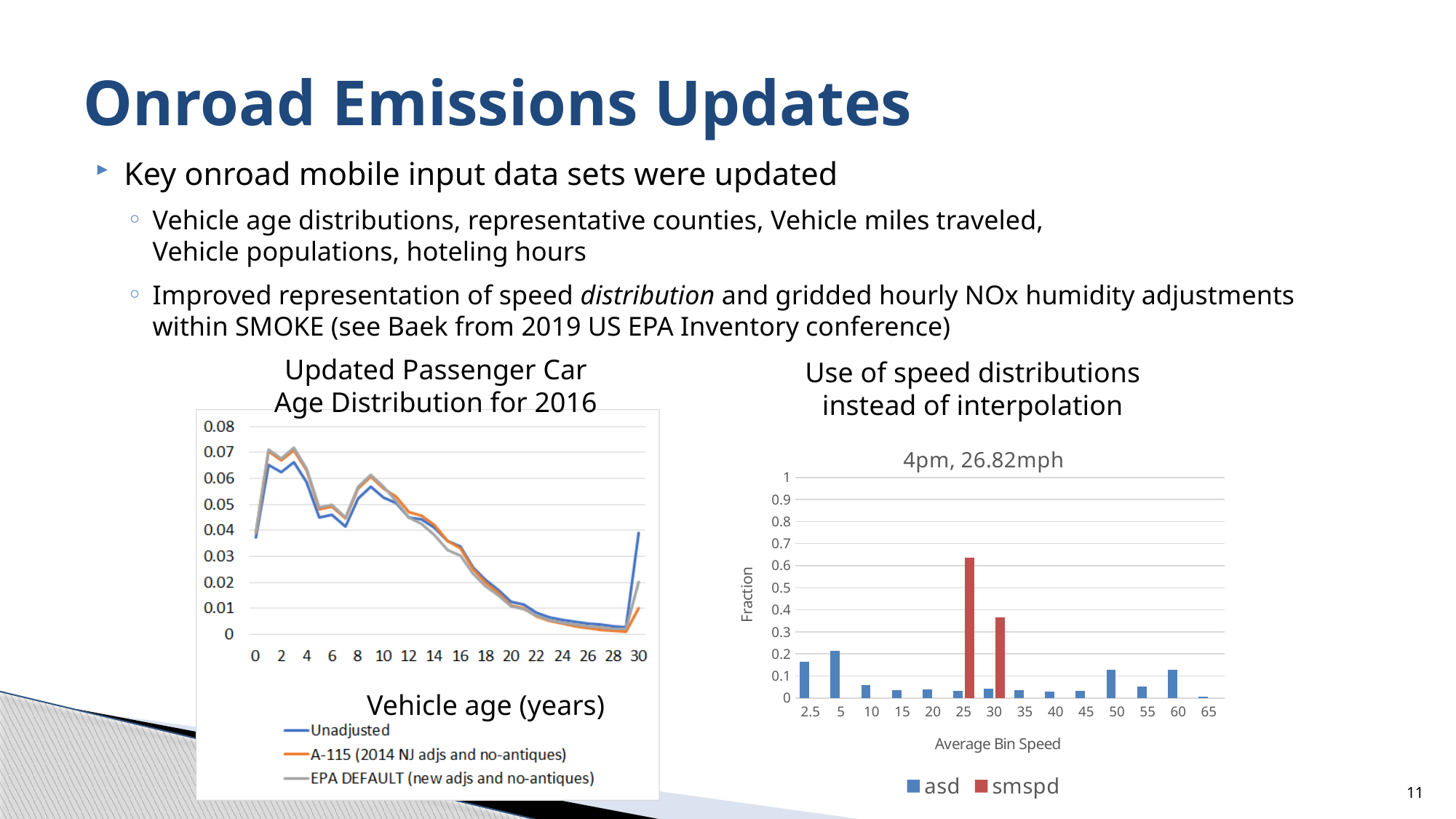
In the 'Updated Passenger Car Age Distribution for 2016' chart, do the values generally rise or fall between vehicle age 10 and vehicle age 28? fall How many series does the legend of the '4pm, 26.82mph' chart list? 2 In the '4pm, 26.82mph' chart, is the smspd value at average bin speed 25 greater or less than 0.5? greater In the 'Updated Passenger Car Age Distribution for 2016' chart, is the Unadjusted value at vehicle age 30 greater or less than 0.03? greater In the '4pm, 26.82mph' chart, at which average bin speed is the smspd value highest? 25 What kind of chart is the '4pm, 26.82mph' chart? bar chart What kind of chart is the 'Updated Passenger Car Age Distribution for 2016' chart? line chart How many series does the legend of the 'Updated Passenger Car Age Distribution for 2016' chart list? 3 In the '4pm, 26.82mph' chart, is the asd value at average bin speed 5 greater or less than 0.1? greater How many average bin speed categories are shown on the x axis of the '4pm, 26.82mph' chart? 14 In the '4pm, 26.82mph' chart, which colour represents the smspd series? red In the 'Updated Passenger Car Age Distribution for 2016' chart, which series has the highest value at vehicle age 30? Unadjusted